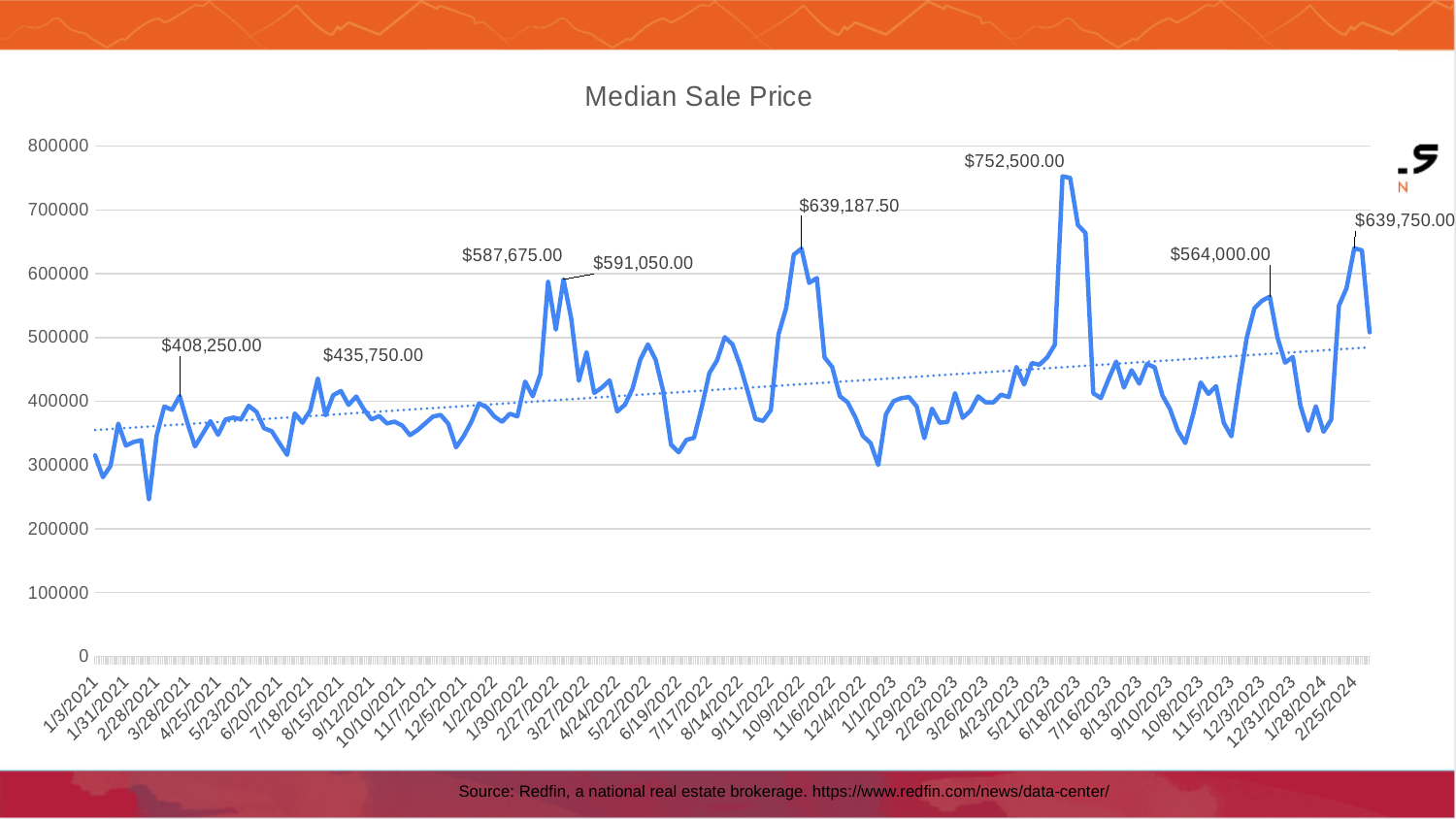
What is the lowest data-labelled value on the chart? $408,250.00 What kind of chart is shown on the slide? line chart What is the labelled value of the peak near 12/3/2023? $564,000.00 What is the difference between the labelled peak of $752,500.00 and the labelled value of $639,750.00 at the right end of the chart? $112,750.00 What is the title of the chart? Median Sale Price What is the difference between the labelled values $591,050.00 and $587,675.00? $3,375.00 Which labelled value is larger, $639,187.50 or $639,750.00? $639,750.00 Is the peak value around 6/18/2023 greater or less than 700000? greater Does the dotted trendline rise or fall from left to right across the chart? rises Is the value at the dip around 2/28/2021 greater or less than 300000? less What is the highest data-labelled value on the chart? $752,500.00 What is the maximum value shown on the vertical axis? 800000